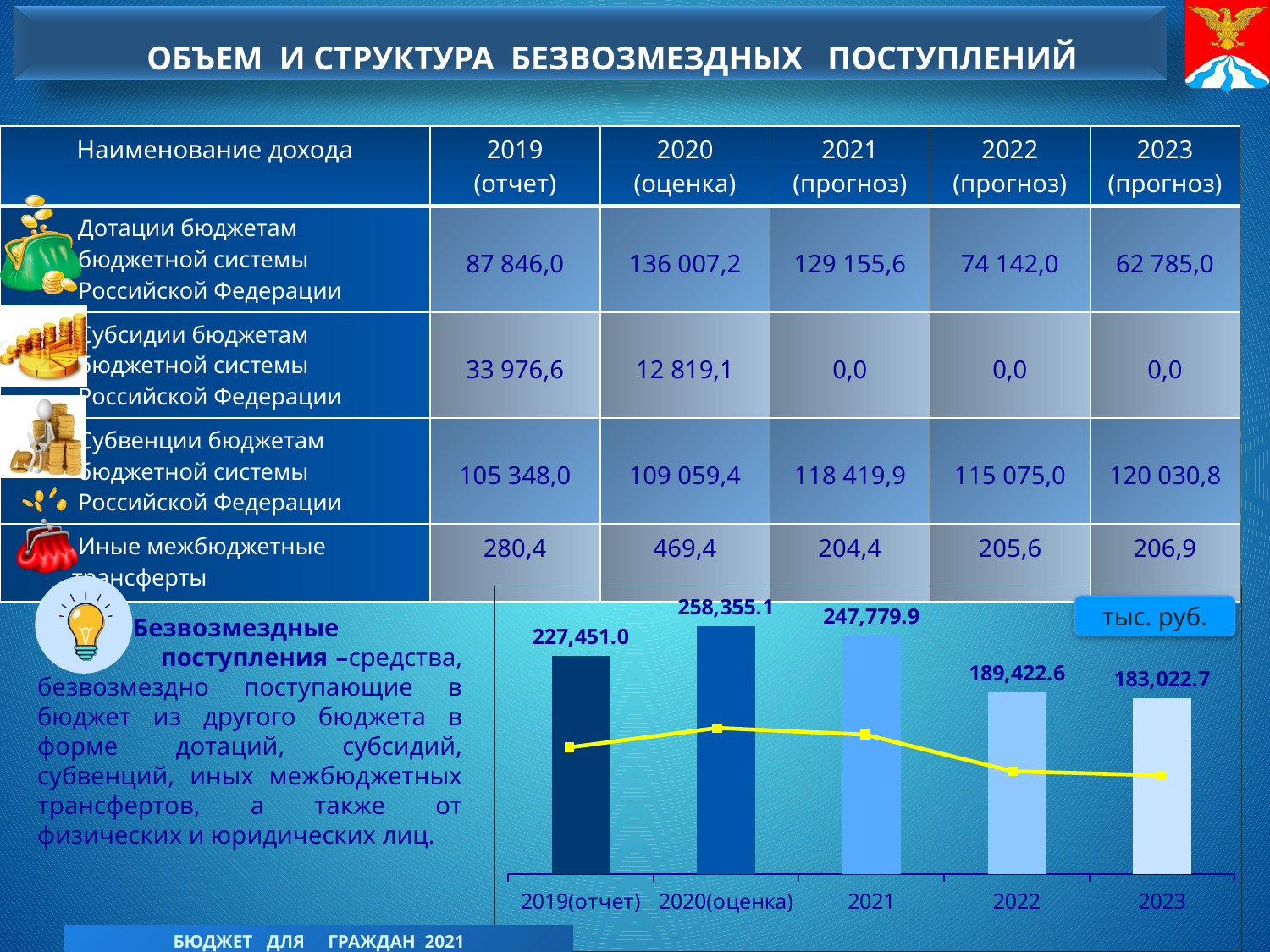
What is the value shown for 2020(оценка) in the bar chart? 258,355.1 What is the value shown for 2021 in the bar chart? 247,779.9 How many years (categories) are shown on the x axis of the bar chart? 5 Which year has the highest bar in the chart? 2020(оценка) What unit is indicated in the label box at the top right of the chart? тыс. руб. Which year has the lowest bar in the chart? 2023 Which is larger in the bar chart, the value for 2019(отчет) or the value for 2021? 2021 What is the value shown for 2023 in the bar chart? 183,022.7 What kind of chart is shown at the bottom right of the slide? bar chart What is the difference between the bar values for 2021 and 2022? 58,357.3 What is the difference between the bar values for 2020(оценка) and 2023? 75,332.4 What is the value shown for 2019(отчет) in the bar chart? 227,451.0